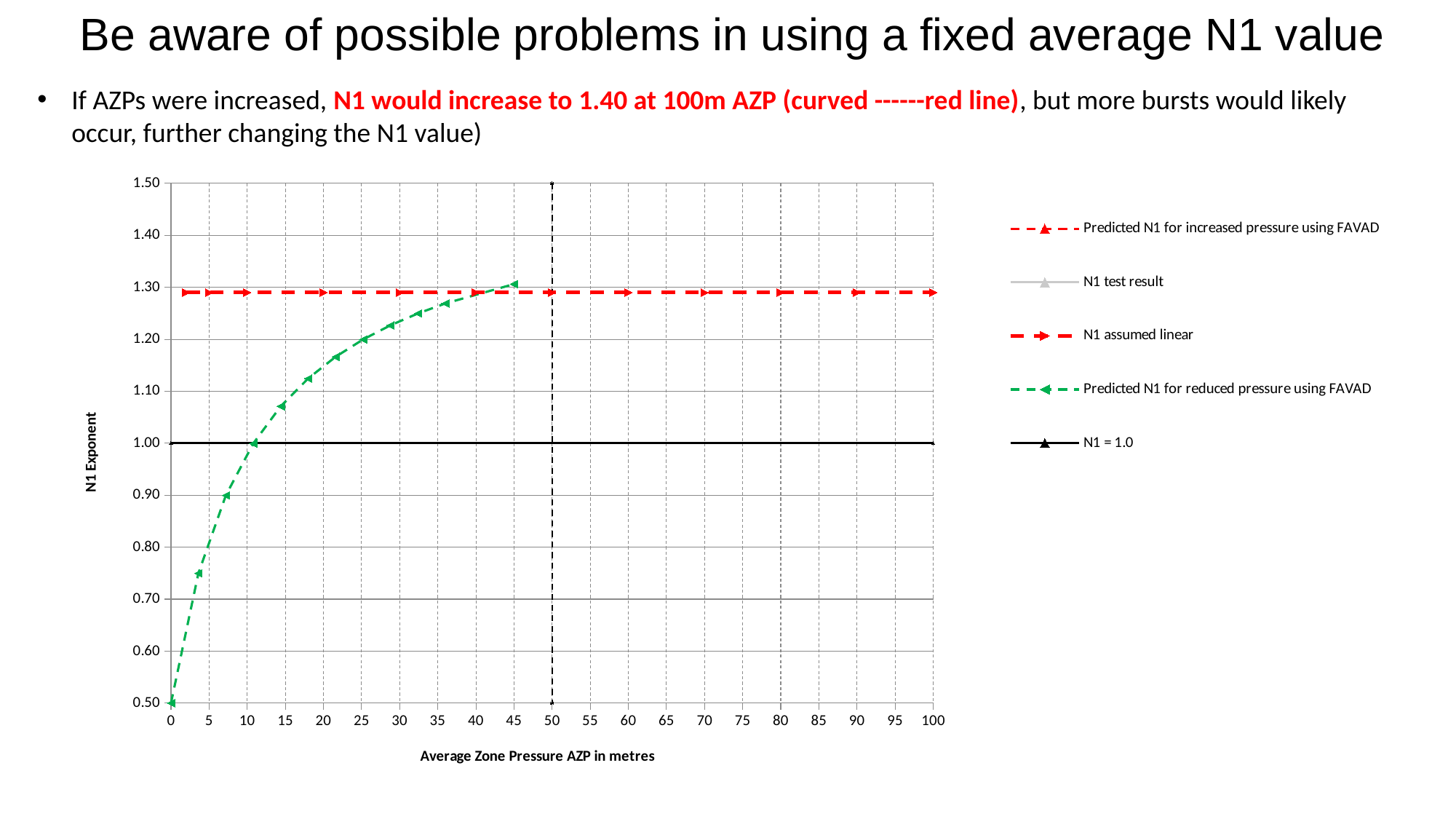
At what AZP value is the vertical dashed line drawn on the chart? 50 What is the value of the 'N1 = 1.0' line on the chart? 1.00 At an AZP of 30 metres, which is higher: the 'Predicted N1 for reduced pressure using FAVAD' curve or the 'N1 = 1.0' line? Predicted N1 for reduced pressure using FAVAD What is the value of the 'Predicted N1 for reduced pressure using FAVAD' curve at an AZP of 0 metres? 0.50 How many series does the chart legend list? 5 What kind of chart is shown on the slide? line chart Is the value of the 'Predicted N1 for reduced pressure using FAVAD' curve at an AZP of 20 metres greater or less than 1.20? less Is the value of the 'Predicted N1 for reduced pressure using FAVAD' curve at an AZP of 15 metres greater or less than 1.00? greater At an AZP of 10 metres, which is higher: the 'Predicted N1 for reduced pressure using FAVAD' curve or the 'N1 assumed linear' line? N1 assumed linear Does the 'Predicted N1 for reduced pressure using FAVAD' curve rise or fall as AZP increases from 0 to 45 metres? rise What is the title of the x axis of the chart? Average Zone Pressure AZP in metres Is the value of the 'N1 assumed linear' line greater or less than 1.20? greater